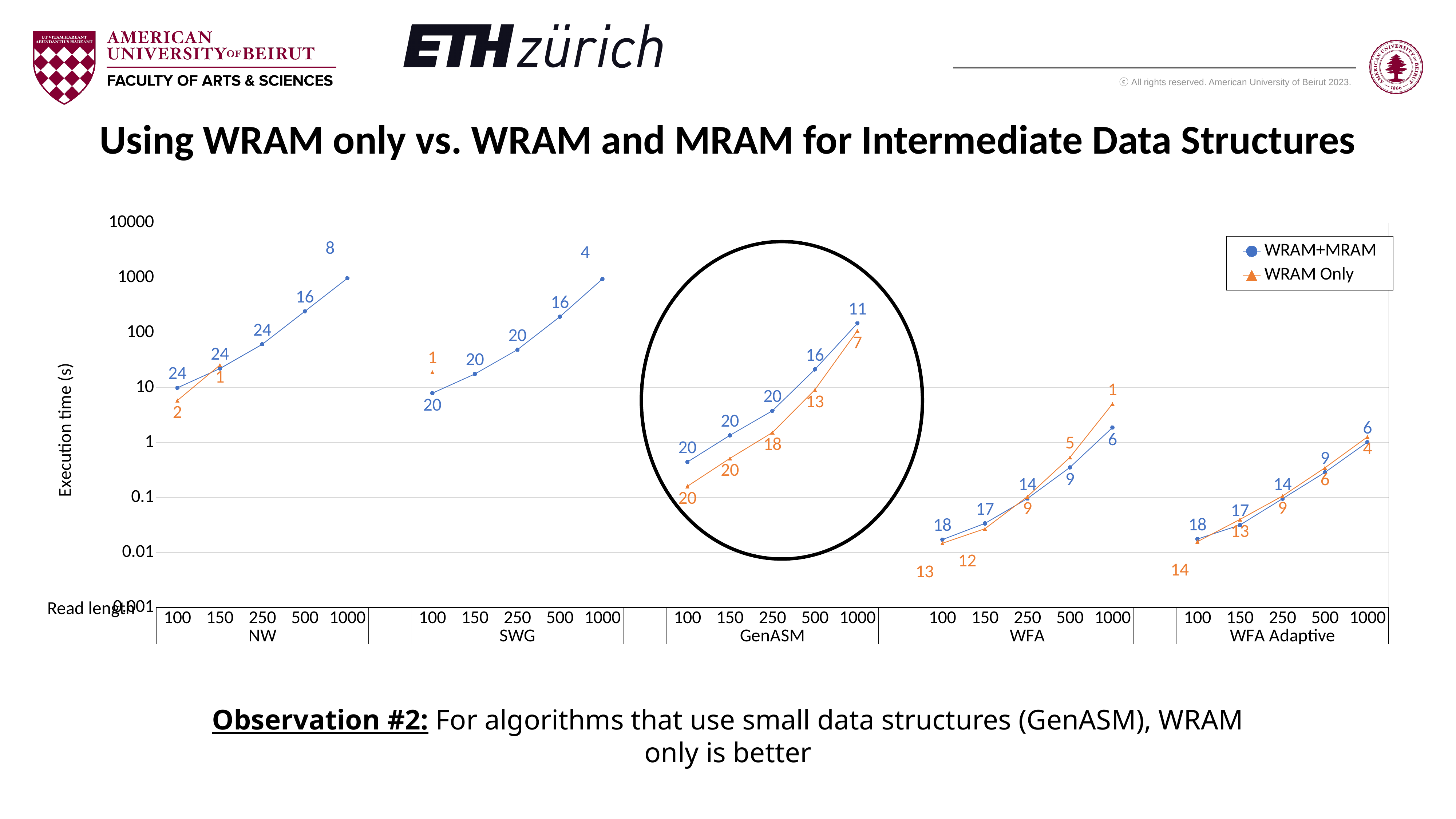
What kind of chart is shown on the slide? line chart For SWG at read length 100, which series has the larger execution time, WRAM+MRAM or WRAM Only? WRAM Only Which algorithm group is circled on the chart? GenASM Is the WRAM+MRAM execution time for GenASM at read length 100 greater or less than 1? less Is the WRAM+MRAM execution time for NW at read length 500 greater or less than 100? greater What are the two series named in the legend? WRAM+MRAM and WRAM Only For NW, does the WRAM+MRAM execution time rise or fall as read length increases from 100 to 1000? rise How many series does the legend list? 2 Is the WRAM+MRAM execution time for GenASM at read length 1000 greater or less than 100? greater For GenASM at read length 250, which series has the larger execution time, WRAM+MRAM or WRAM Only? WRAM+MRAM How many algorithm groups are shown along the x axis? 5